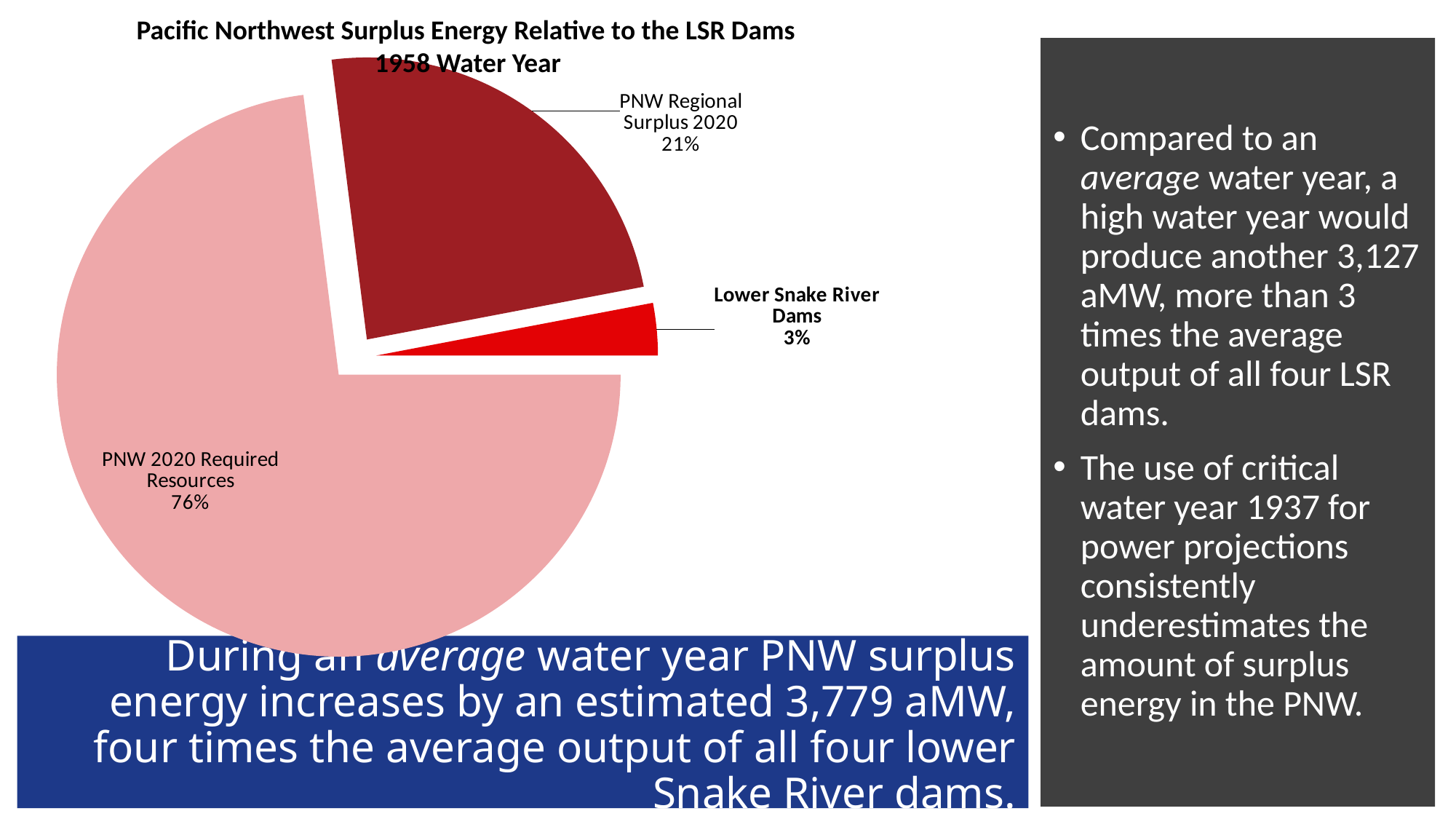
What share of the pie is PNW 2020 Required Resources? 76% Which is larger, PNW Regional Surplus 2020 or Lower Snake River Dams? PNW Regional Surplus 2020 What share of the pie is PNW Regional Surplus 2020? 21% How many slices does the pie chart have? 3 Which slice of the pie is the smallest? Lower Snake River Dams What colour is the Lower Snake River Dams slice? bright red What is the difference in percentage points between PNW 2020 Required Resources and PNW Regional Surplus 2020? 55 percentage points Which slice of the pie is the largest? PNW 2020 Required Resources What is the difference in percentage points between PNW Regional Surplus 2020 and Lower Snake River Dams? 18 percentage points What kind of chart is shown on the slide? pie chart What share of the pie is Lower Snake River Dams? 3% What is the title of the chart? Pacific Northwest Surplus Energy Relative to the LSR Dams 1958 Water Year